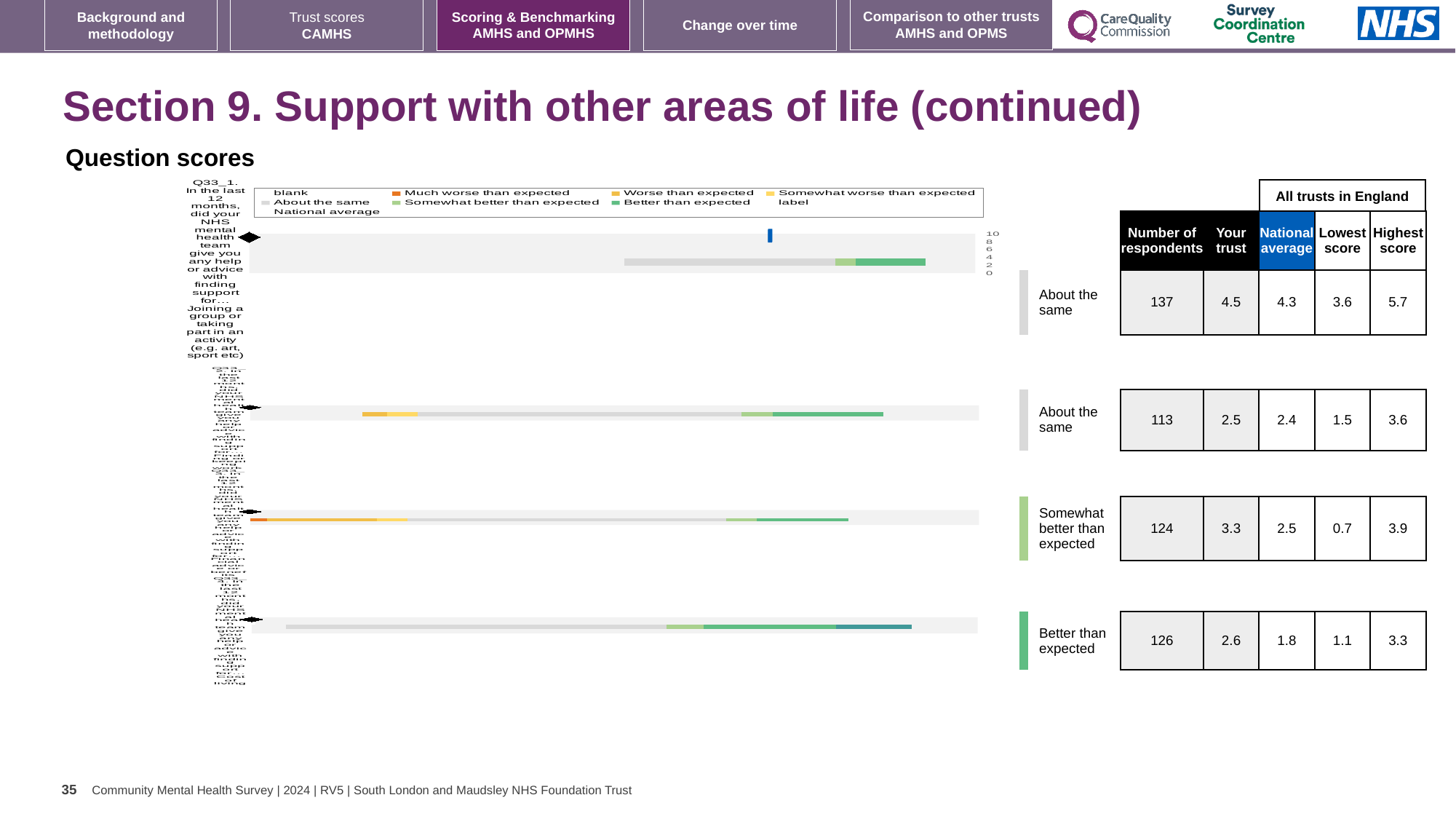
What benchmark category is shown next to the fourth (bottom) bar? Better than expected Which bar has the highest 'Your trust' score? The first bar (Q33_1), 4.5 What is the national average for the first bar (Q33_1)? 4.3 What is the difference between the 'Your trust' score and the national average for the third bar? 0.8 What is the lowest score across all trusts in England for the third bar? 0.7 How many respondents are listed for the first bar (Q33_1)? 137 What is the highest score across all trusts in England for the second bar? 3.6 For the third bar, which is larger: the 'Your trust' score or the national average? Your trust (3.3) What kind of chart is shown under 'Question scores'? Bar chart How many question bars are plotted in the chart? 4 Which bar has the fewest respondents? The second bar, 113 What is the 'Your trust' score for the first bar (Q33_1, joining a group or taking part in an activity)? 4.5